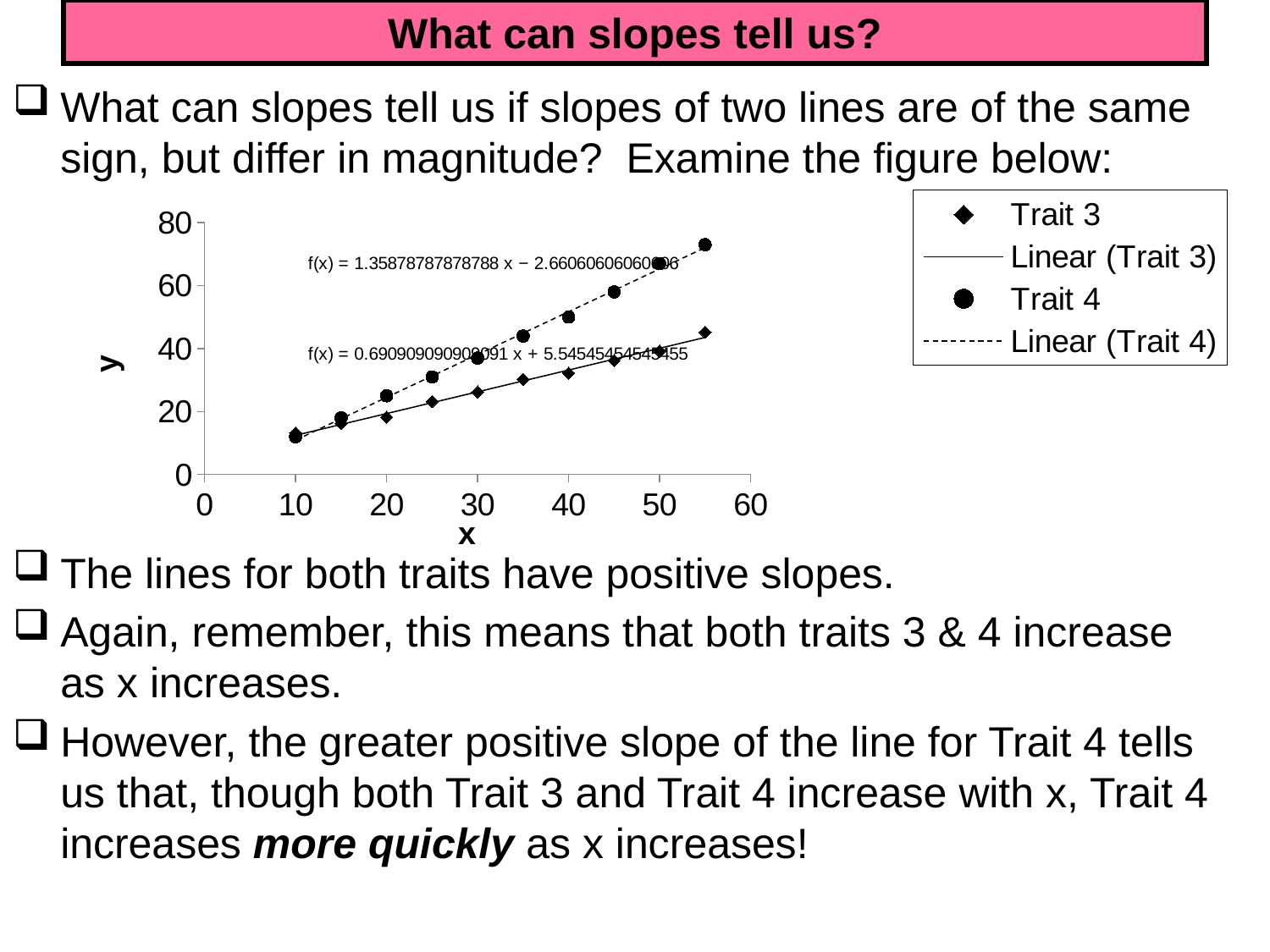
Is the y value for Trait 3 at x = 10 greater or less than 20? less Which legend entry is drawn as a dashed line? Linear (Trait 4) At x = 55, which series has the larger y value, Trait 3 or Trait 4? Trait 4 Is the y value for Trait 4 at x = 55 greater or less than 60? greater According to the equation printed on the chart, what is the slope of the Linear (Trait 4) trendline? 1.35878787878788 How many entries does the chart legend list? 4 What kind of chart is shown on the slide? scatter chart Do the Trait 4 values rise or fall as x increases? rise According to the equation printed on the chart, what is the intercept of the Linear (Trait 3) trendline? 5.54545454545455 How many data points are plotted for Trait 3? 10 What is the title of the vertical axis of the chart? y Is the y value for Trait 4 at x = 40 greater or less than 40? greater